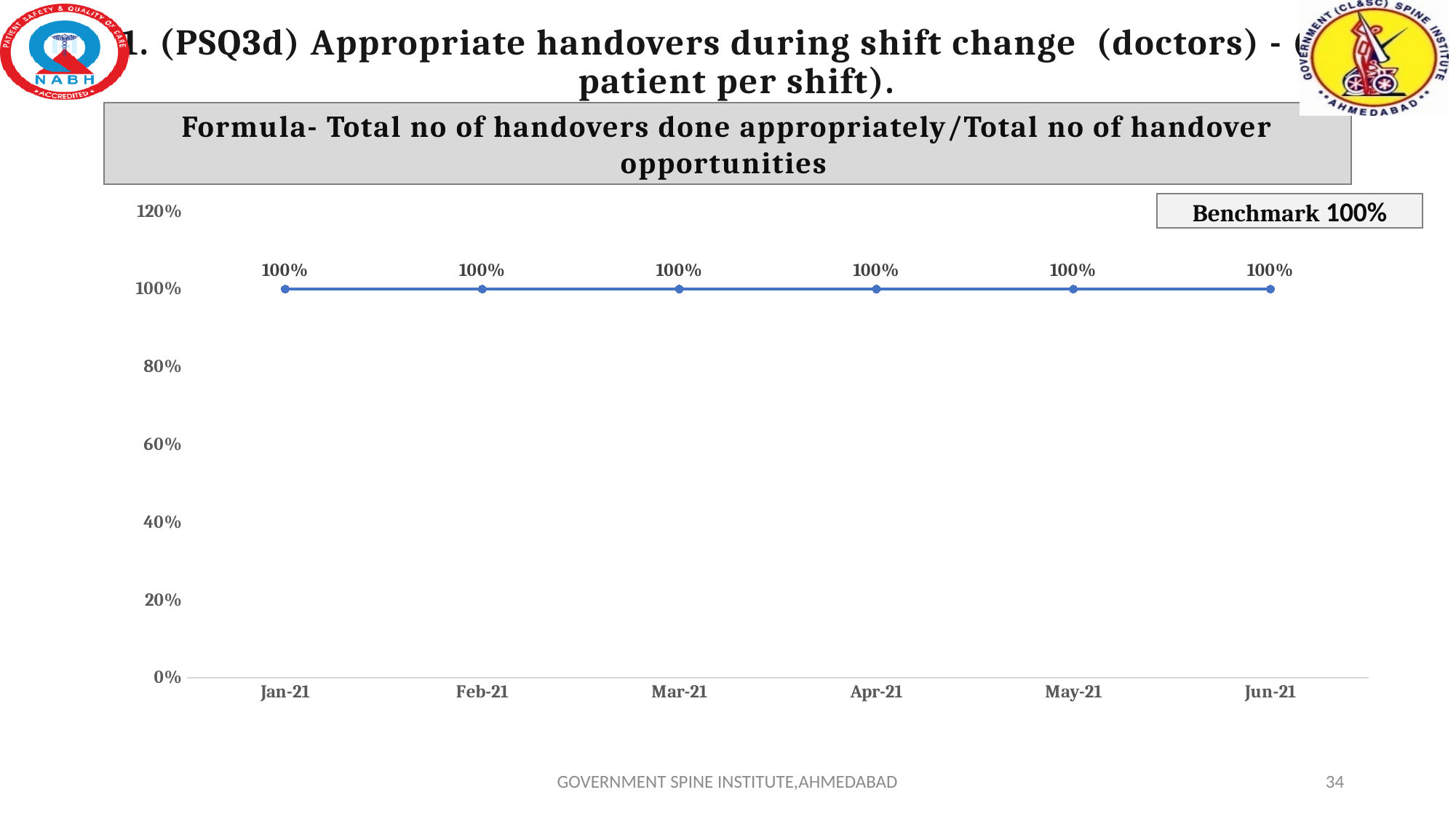
What is the value for Mar-21? 100% What is the value for Jun-21? 100% Is the value for May-21 greater or less than 80%? greater Do the values rise, fall or stay flat from Jan-21 to Jun-21? Stay flat Is the value for Jan-21 greater or less than 120%? less What is the value for Apr-21? 100% What is the value for Jan-21? 100% What benchmark value is stated on the slide? 100% What kind of chart is shown on the slide? Line chart What is the highest value shown on the y axis? 120% How many months are plotted on the x axis? 6 What is the difference between the values for Feb-21 and May-21? 0%